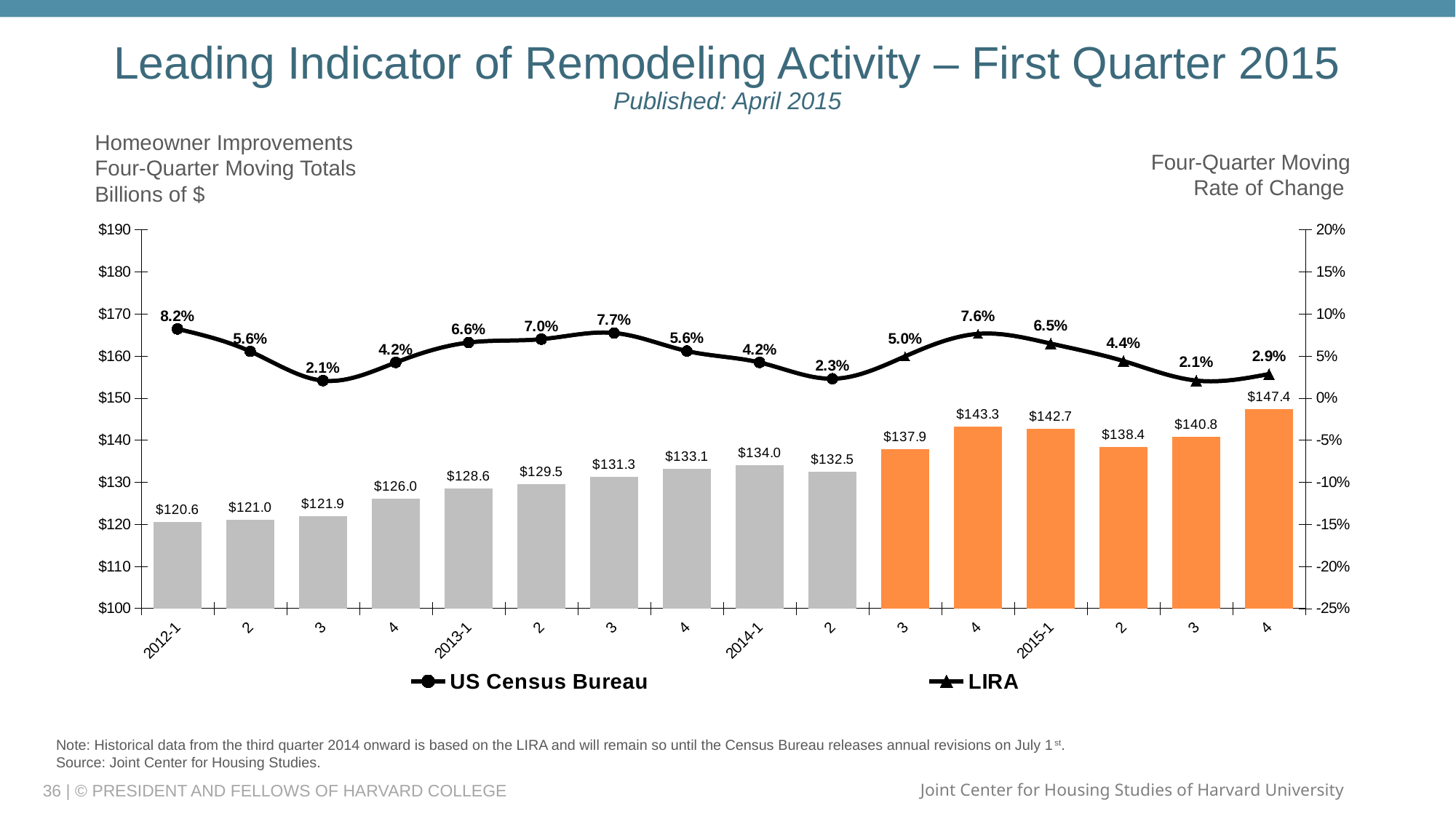
What are the two entries in the chart legend? US Census Bureau and LIRA How many series does the legend list? 2 What is the rate of change shown for the fourth quarter of 2015? 2.9% Which quarter has the highest four-quarter moving total bar? 2015-4 ($147.4) Which quarter has the highest four-quarter moving rate of change on the line? 2012-1 (8.2%) What kind of chart is shown on the slide? Combined bar and line chart Which quarter has the lowest four-quarter moving total bar? 2012-1 ($120.6) What is the four-quarter moving rate of change shown for the third quarter of 2013? 7.7% Which is larger, the four-quarter moving total for 2014-4 or for 2015-1? 2014-4 ($143.3) What is the four-quarter moving total for 2014-1? $134.0 How many quarterly bars are plotted on the chart? 16 What is the difference between the four-quarter moving total for 2015-4 and for 2012-1? $26.8